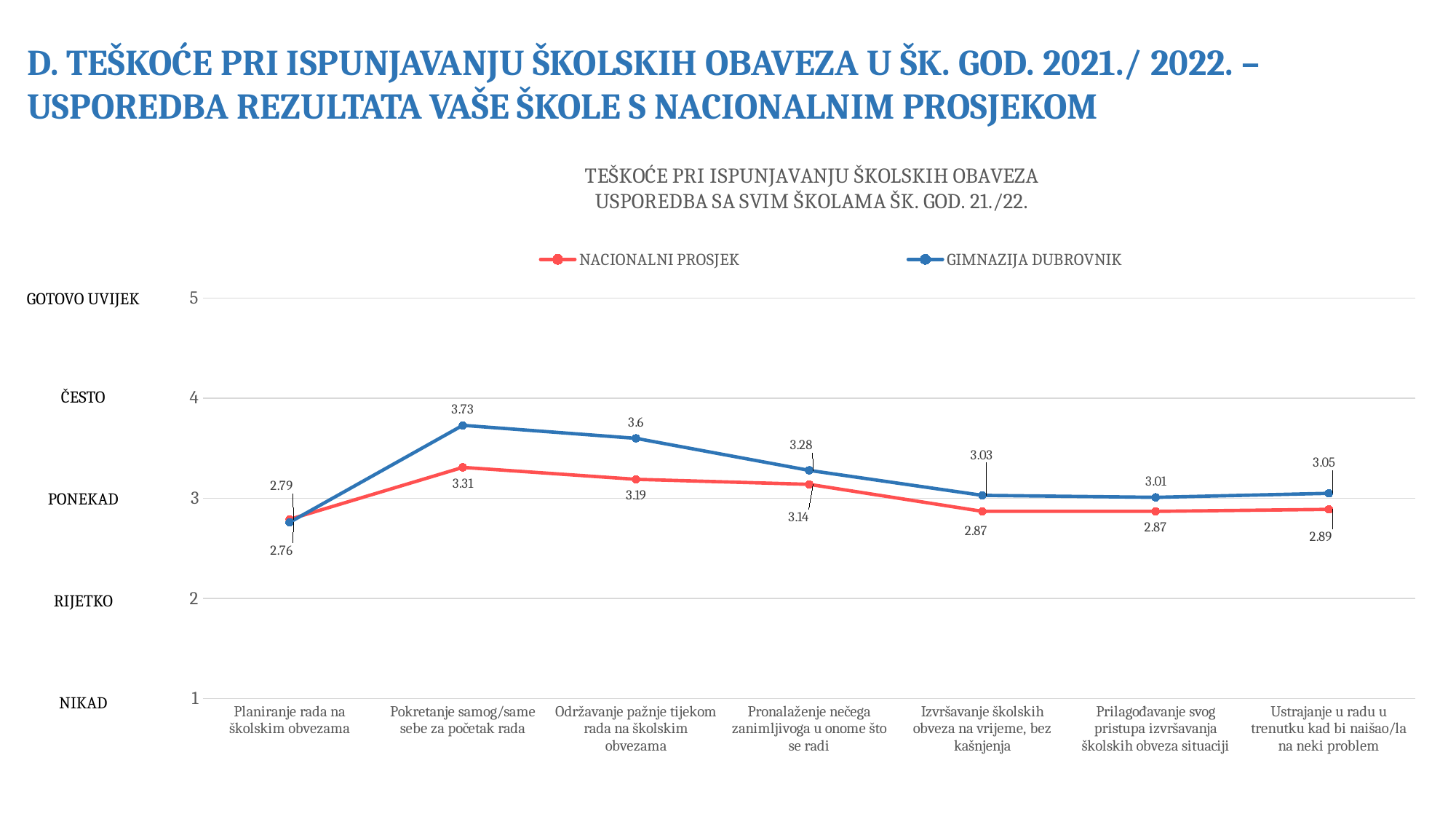
What is the difference between GIMNAZIJA DUBROVNIK and NACIONALNI PROSJEK for 'Pokretanje samog/same sebe za početak rada'? 0.42 What is the difference between GIMNAZIJA DUBROVNIK and NACIONALNI PROSJEK for 'Pronalaženje nečega zanimljivoga u onome što se radi'? 0.14 Which category has the highest value for GIMNAZIJA DUBROVNIK? Pokretanje samog/same sebe za početak rada Which series is drawn in blue? GIMNAZIJA DUBROVNIK What is the value for NACIONALNI PROSJEK for 'Održavanje pažnje tijekom rada na školskim obvezama'? 3.19 What is the value for GIMNAZIJA DUBROVNIK for 'Ustrajanje u radu u trenutku kad bi naišao/la na neki problem'? 3.05 What type of chart is shown on the slide? line chart How many categories are shown on the x axis? 7 What is the value for GIMNAZIJA DUBROVNIK for 'Pokretanje samog/same sebe za početak rada'? 3.73 Is the value for NACIONALNI PROSJEK for 'Izvršavanje školskih obveza na vrijeme, bez kašnjenja' greater or less than 3? less For 'Održavanje pažnje tijekom rada na školskim obvezama', which series has the larger value, NACIONALNI PROSJEK or GIMNAZIJA DUBROVNIK? GIMNAZIJA DUBROVNIK How many series does the legend list? 2